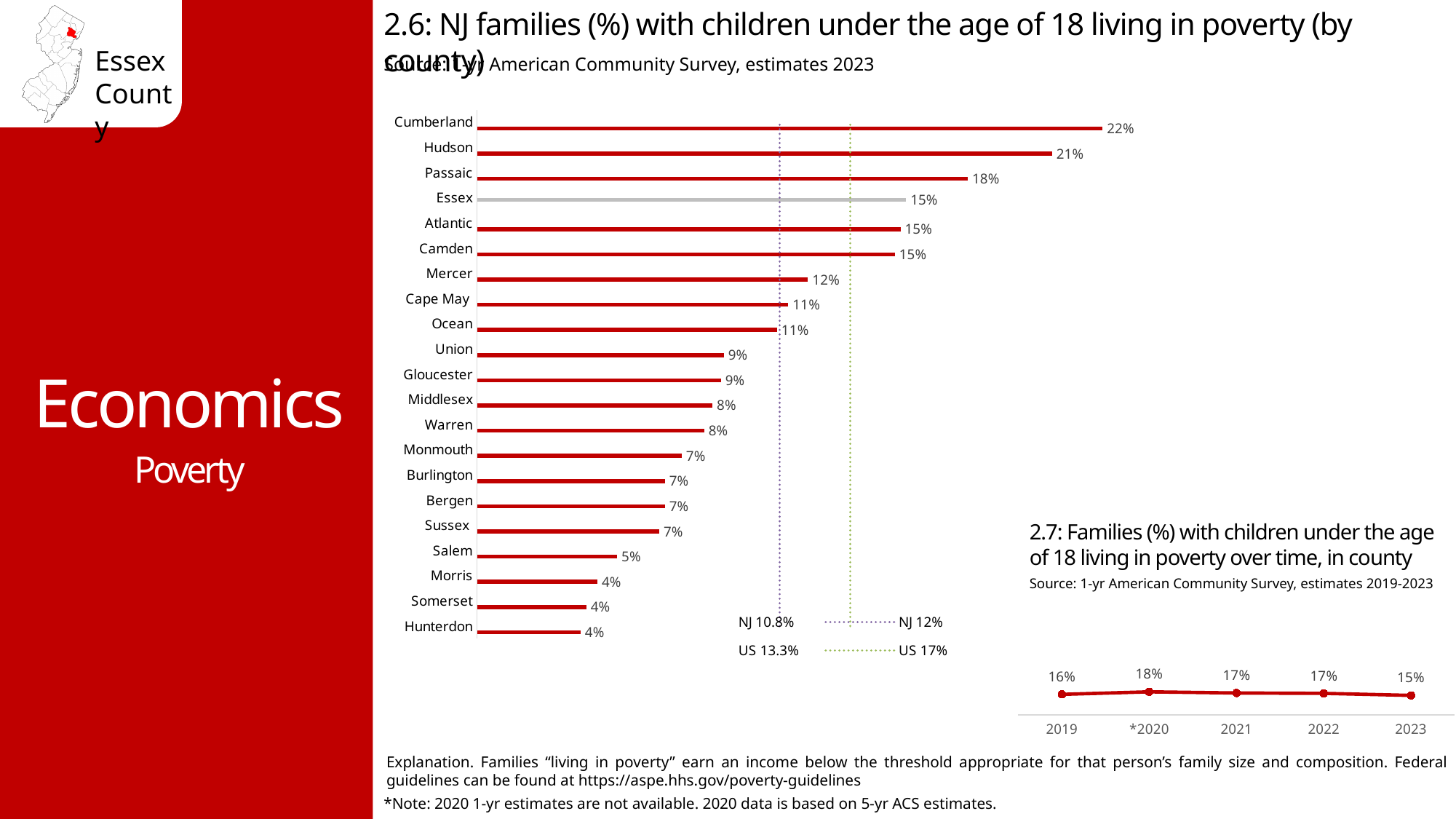
In chart 2.7 (families with children under 18 living in poverty over time, in county), how many years are plotted? 5 In chart 2.6 (NJ families with children under 18 living in poverty by county), what is the value for Hudson? 21% In chart 2.7 (families with children under 18 living in poverty over time, in county), which year has the highest value? *2020 In chart 2.7 (families with children under 18 living in poverty over time, in county), what is the value for 2023? 15% In chart 2.6 (NJ families with children under 18 living in poverty by county), which is larger, Mercer or Union? Mercer In chart 2.6 (NJ families with children under 18 living in poverty by county), what is the difference between Cumberland and Passaic? 4% What kind of chart is chart 2.7 (families with children under 18 living in poverty over time, in county)? Line chart In chart 2.6 (NJ families with children under 18 living in poverty by county), what is the value for Essex? 15% In chart 2.6 (NJ families with children under 18 living in poverty by county), which county has the highest value? Cumberland What kind of chart is chart 2.6 (NJ families with children under 18 living in poverty by county)? Bar chart In chart 2.6 (NJ families with children under 18 living in poverty by county), what is the value for Salem? 5% In chart 2.6 (NJ families with children under 18 living in poverty by county), how many counties are shown? 21